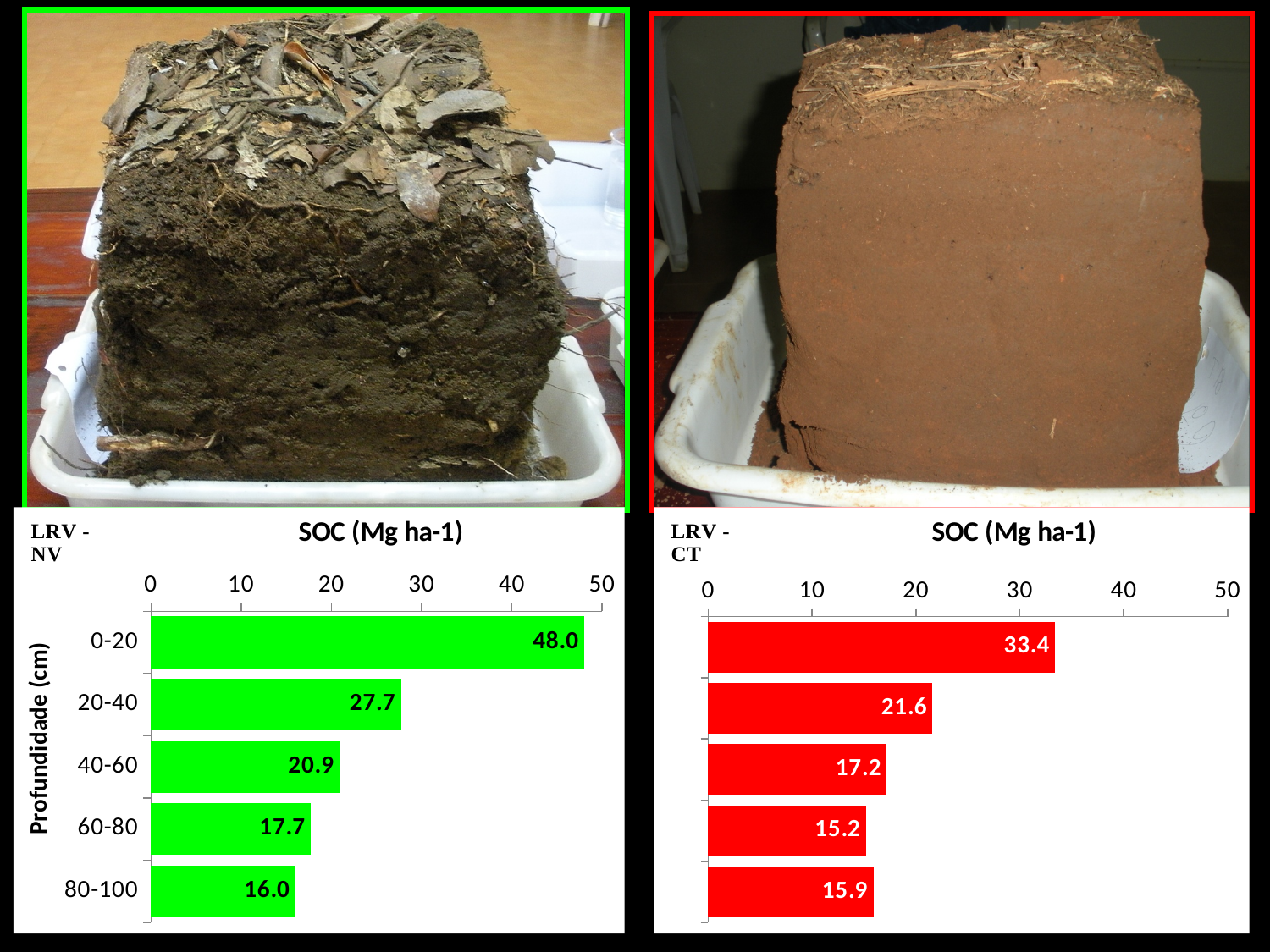
What is the difference between the top bar of the left chart (LRV - NV) and the top bar of the right chart (LRV - CT)? 14.6 In the left chart (LRV - NV), which depth has the lowest SOC value? 80-100 In the left chart (LRV - NV), what is the difference between the SOC values for 0-20 and 20-40 cm? 20.3 How many bars does the left chart (LRV - NV) have? 5 In the left chart (LRV - NV), what is the SOC value for the 0-20 cm depth? 48.0 In the left chart (LRV - NV), what is the SOC value for the 40-60 cm depth? 20.9 In the right chart (LRV - CT), what is the value of the top bar? 33.4 What is the y-axis label of the left chart (LRV - NV)? Profundidade (cm) Which is larger: the 60-80 cm value in the left chart (LRV - NV) or the fourth bar in the right chart (LRV - CT)? Left chart (17.7) In the right chart (LRV - CT), what is the value of the bottom bar? 15.9 What type of chart is used in the right chart (LRV - CT)? Bar chart In the right chart (LRV - CT), what is the lowest value shown? 15.2